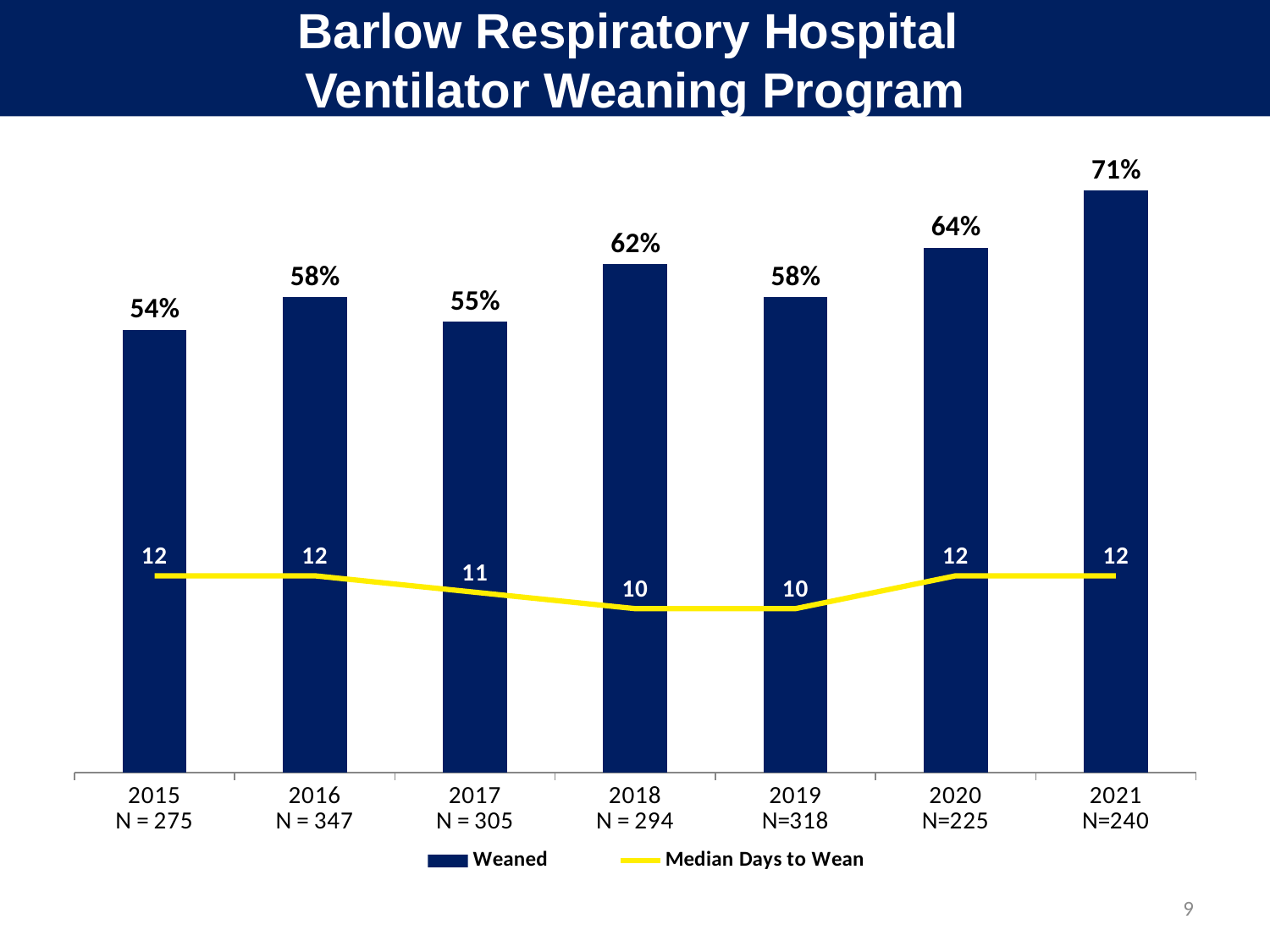
Which year has the lowest Weaned percentage? 2015 Which year has a higher Weaned percentage, 2018 or 2019? 2018 How many years are shown on the x axis? 7 How many series does the legend list? 2 What is the N value shown for 2016? N = 347 What is the Weaned percentage for 2015? 54% What is the Weaned percentage for 2021? 71% What kind of chart is used to show the Weaned series? Bar chart What is the Median Days to Wean value for 2018? 10 What is the Median Days to Wean value for 2017? 11 What is the difference in Weaned percentage between 2021 and 2015? 17% Which year has the highest Weaned percentage? 2021